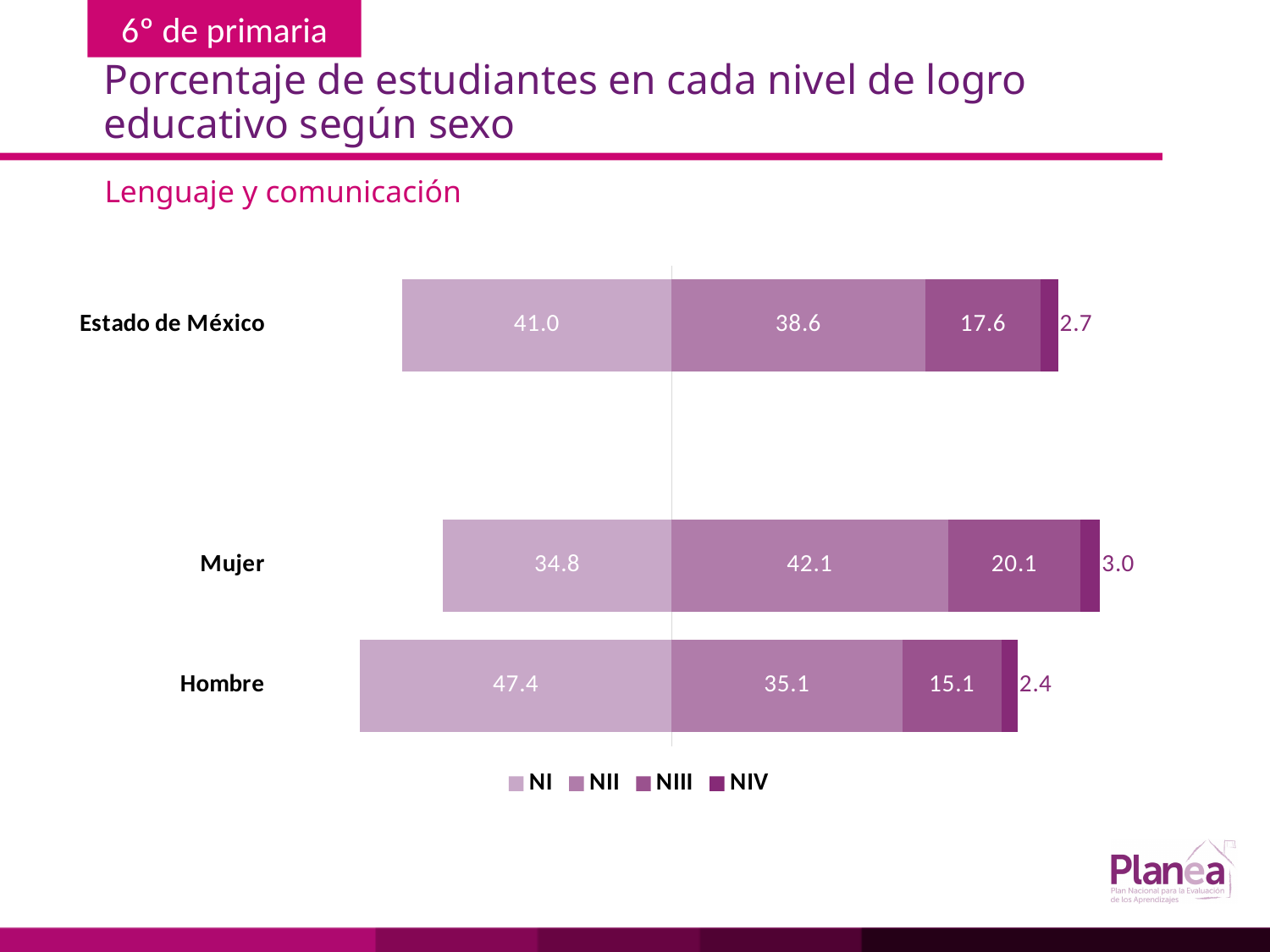
What kind of chart is shown on the slide? Stacked bar chart What is the NIII value for Hombre? 15.1 What is the total of the stacked bar for Mujer? 100.0 How many categories are plotted on the chart? 3 What is the NIV value for Estado de México? 2.7 Which category has the lowest NIV value? Hombre What is the NI value for Hombre? 47.4 What is the difference between the NI values for Hombre and Mujer? 12.6 Which category has the highest NI value? Hombre How many series does the legend list? 4 Which is larger, the NIII value for Mujer or the NIII value for Estado de México? Mujer What is the NII value for Mujer? 42.1